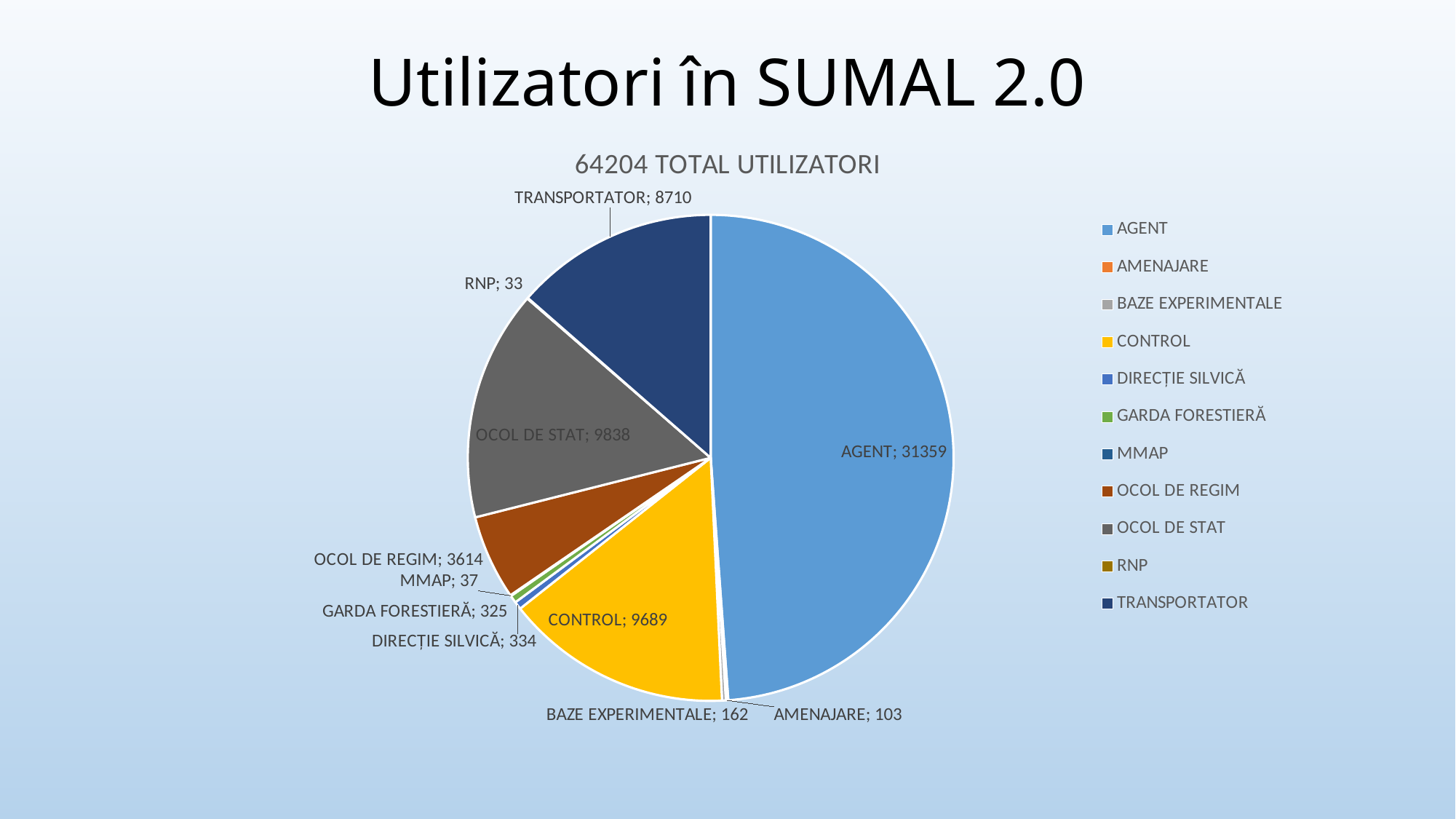
Which category has the largest slice of the pie? AGENT How many categories does the pie chart show? 11 What is the difference between the values for TRANSPORTATOR and OCOL DE REGIM? 5096 What total number of users is stated in the chart title? 64204 What is the value shown for TRANSPORTATOR? 8710 How many users are in the AGENT category? 31359 What colour is the slice for CONTROL? Yellow What is the difference between the values for OCOL DE STAT and CONTROL? 149 Which category has the smallest value? RNP What is the value shown for OCOL DE STAT? 9838 What kind of chart is shown on the slide? Pie chart Which is larger, the value for CONTROL or the value for TRANSPORTATOR? CONTROL